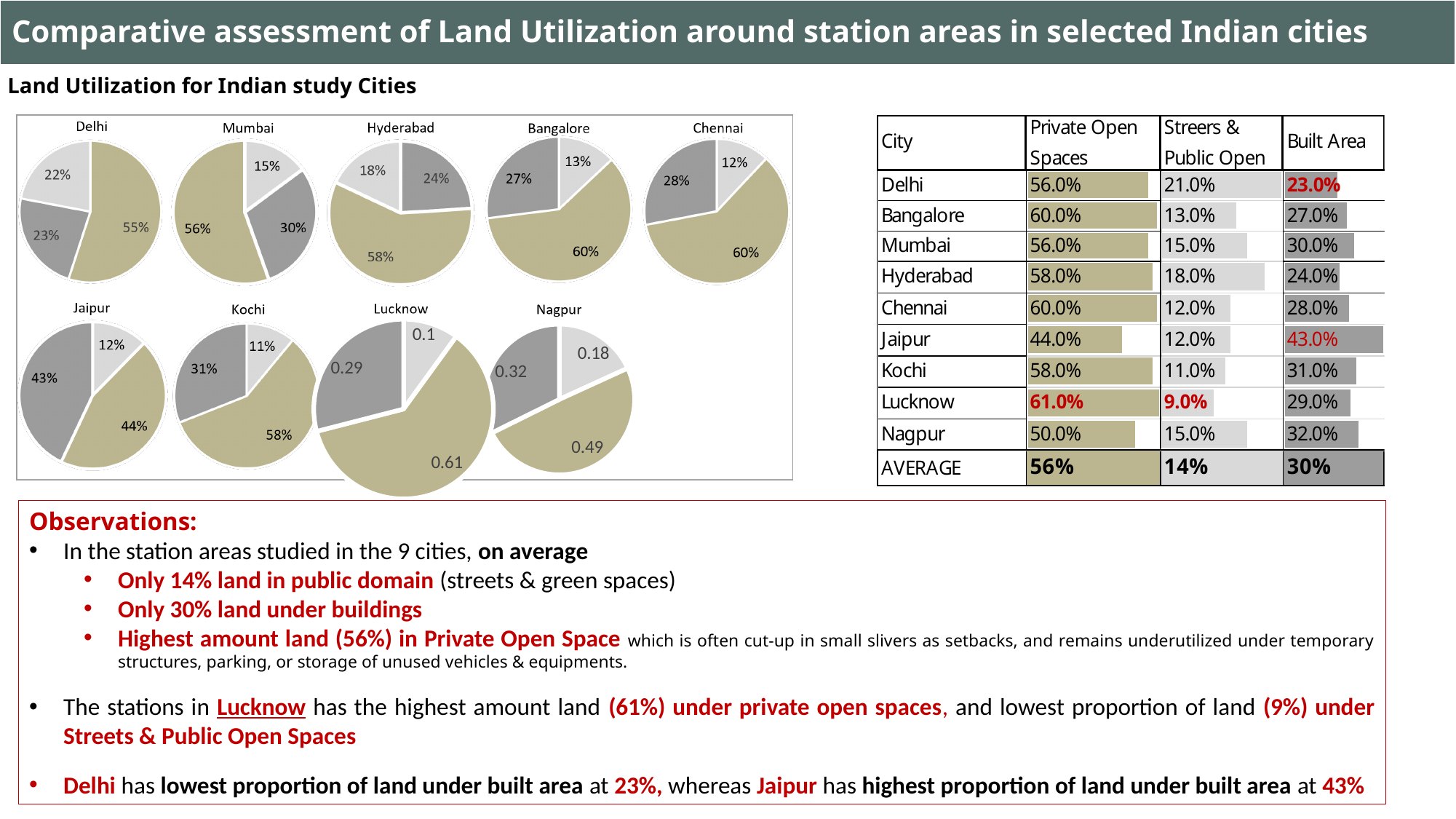
What kind of chart is used to show land utilization for Delhi? pie chart In the Jaipur pie chart, what is the value of the smallest slice? 12% In the Lucknow pie chart, what is the value of the largest slice? 0.61 How many pie charts are shown on the slide? 9 In the Kochi pie chart, what is the difference between the largest slice (58%) and the smallest slice (11%)? 47% In the Delhi pie chart, what is the value of the largest slice? 55% How many slices does the Kochi pie chart have? 3 In the Mumbai pie chart, what is the difference between the largest slice (56%) and the smallest slice (15%)? 41% Which pie chart has the larger biggest slice, Bangalore or Hyderabad? Bangalore Which city's pie chart is drawn noticeably larger than the others on the slide? Lucknow In the Nagpur pie chart, what is the value of the smallest slice? 0.18 In the Chennai pie chart, what is the value of the dark grey slice? 28%